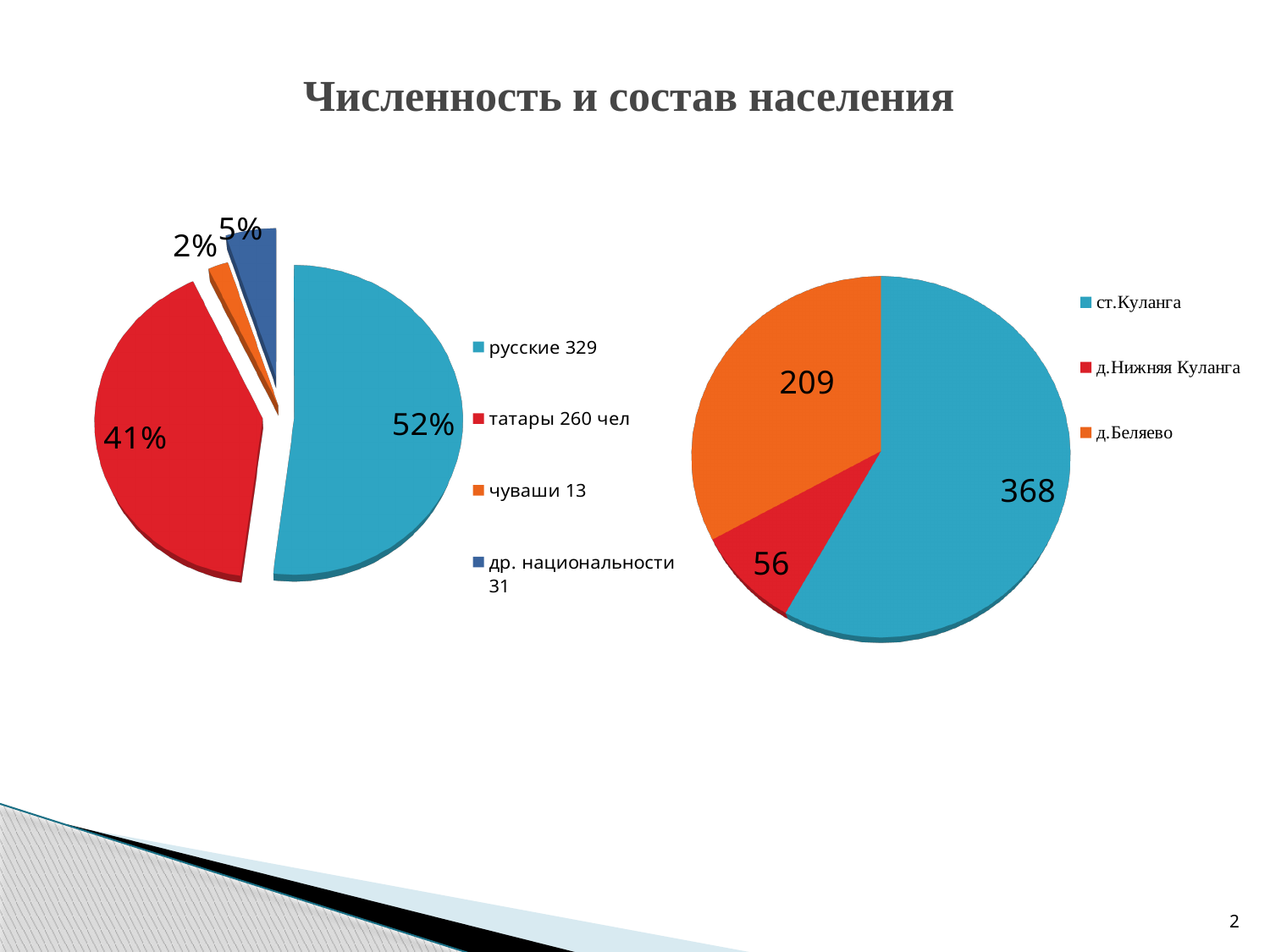
On the left pie chart, what percentage is shown for the татары slice? 41% On the right pie chart, which is larger, д.Беляево or д.Нижняя Куланга? д.Беляево On the left pie chart, which category has the smallest share? чуваши What type of chart is the right chart? Pie chart On the right pie chart, what is the difference between the values for ст.Куланга and д.Беляево? 159 On the right pie chart, what value is shown for д.Беляево? 209 On the left pie chart, what percentage is shown for the русские slice? 52% On the right pie chart, what value is shown for д.Нижняя Куланга? 56 On the left pie chart, which category has the largest share? русские On the left pie chart, how many categories does the legend list? 4 On the left pie chart, what percentage is shown for the чуваши slice? 2% On the right pie chart, what value is shown for ст.Куланга? 368